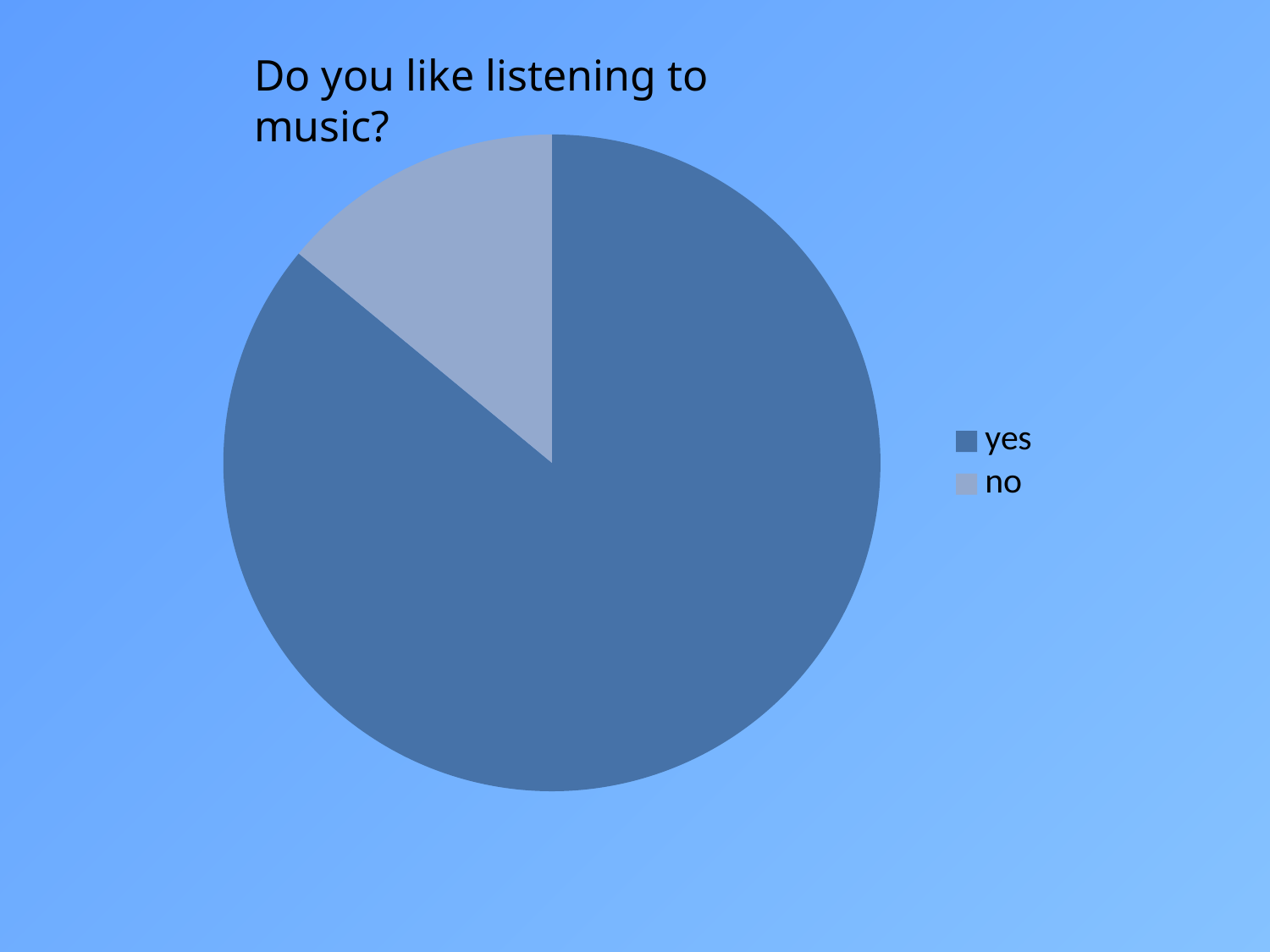
Which slice is larger, yes or no? yes What kind of chart is shown on the slide? pie chart Does the 'yes' slice take up more or less than half of the pie? more What colour is the slice for 'no'? light grey-blue Which category has the smallest slice of the pie? no Which category has the largest slice of the pie? yes How many categories does the legend list? 2 What is the title of the chart? Do you like listening to music?